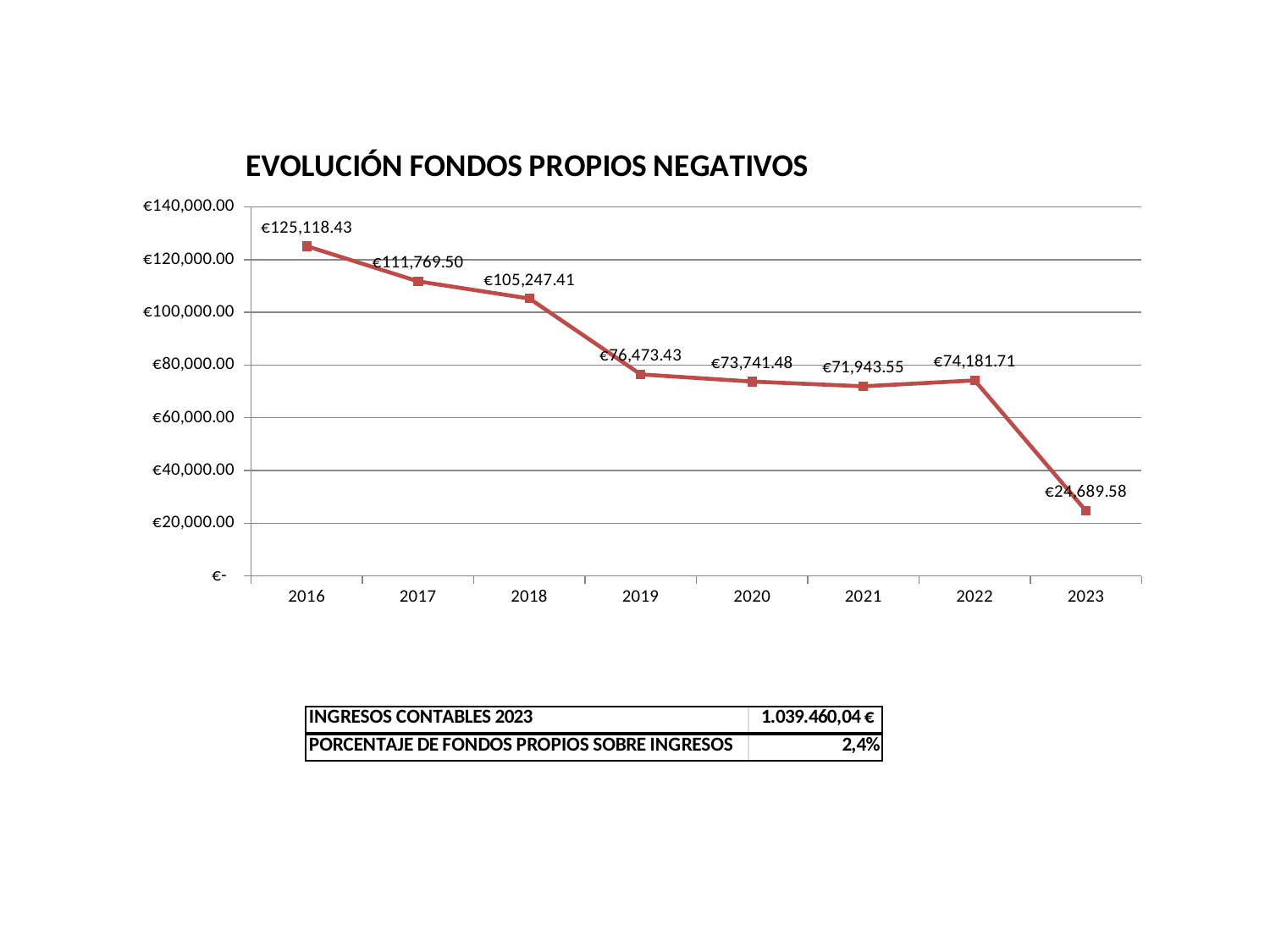
Which is larger, the value for 2021 or the value for 2022? 2022 What kind of chart is shown on the slide? line chart What is the value for 2016 in the chart? €125,118.43 Is the value for 2019 greater or less than €80,000.00? less What is the title of the chart? EVOLUCIÓN FONDOS PROPIOS NEGATIVOS What is the difference between the values for 2022 and 2023? €49,492.13 Which year has the lowest value in the chart? 2023 What is the value for 2019 in the chart? €76,473.43 Which year has the highest value in the chart? 2016 How many years are plotted in the chart? 8 What is the value for 2023 in the chart? €24,689.58 What is the difference between the values for 2016 and 2017? €13,348.93